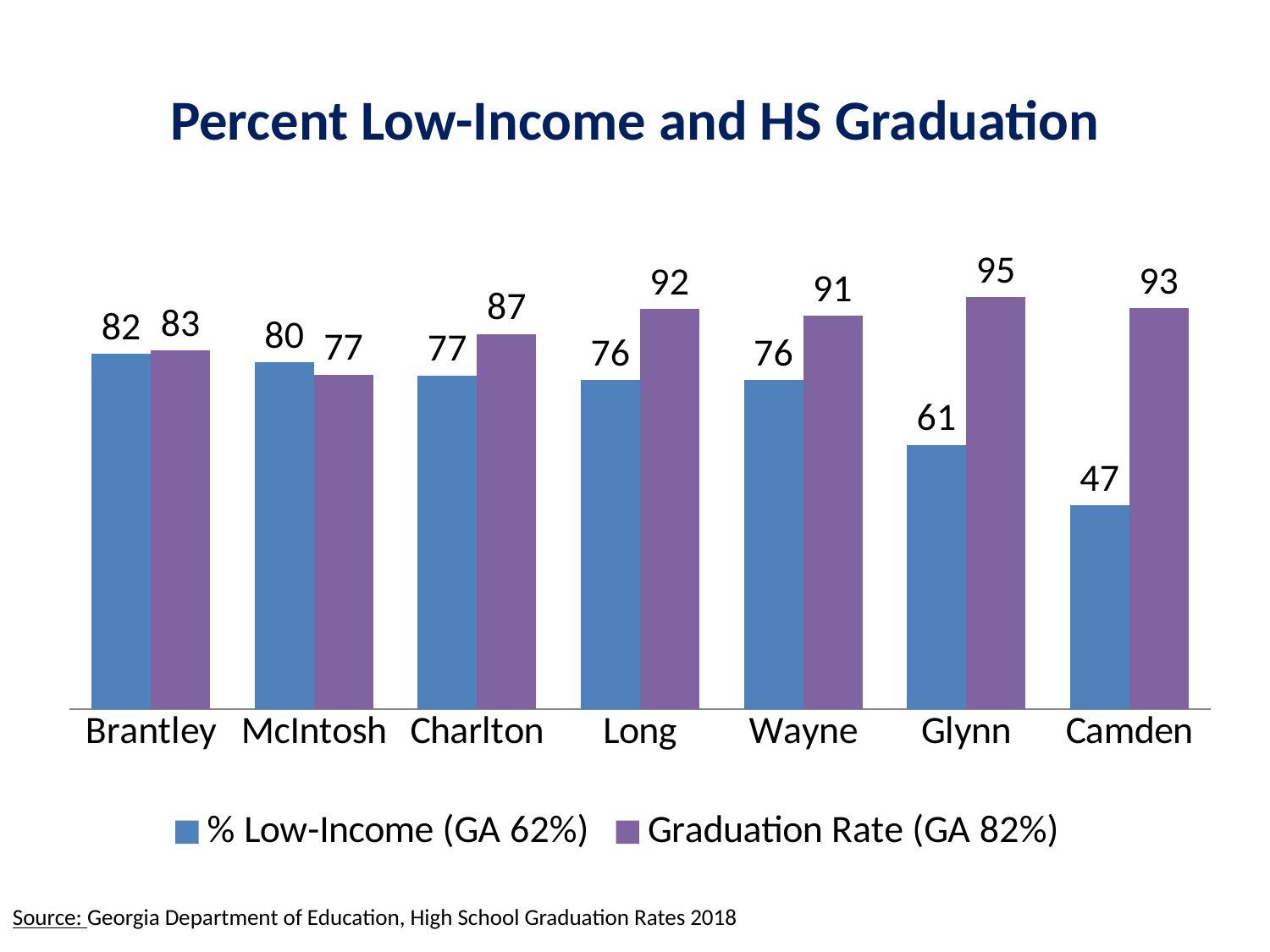
How many series does the legend list? 2 What is the title of the chart? Percent Low-Income and HS Graduation What is the difference between the Graduation Rate and the % Low-Income value for Camden? 46 What kind of chart is shown on the slide? Bar chart What is the % Low-Income value for Brantley? 82 Which county has the highest Graduation Rate? Glynn Which county has the lowest % Low-Income value? Camden Do the % Low-Income values rise or fall from Brantley to Camden along the x axis? Fall What is the Graduation Rate for Glynn? 95 Which is larger for McIntosh, the % Low-Income value or the Graduation Rate? % Low-Income How many counties are shown on the x axis? 7 What is the % Low-Income value for Camden? 47